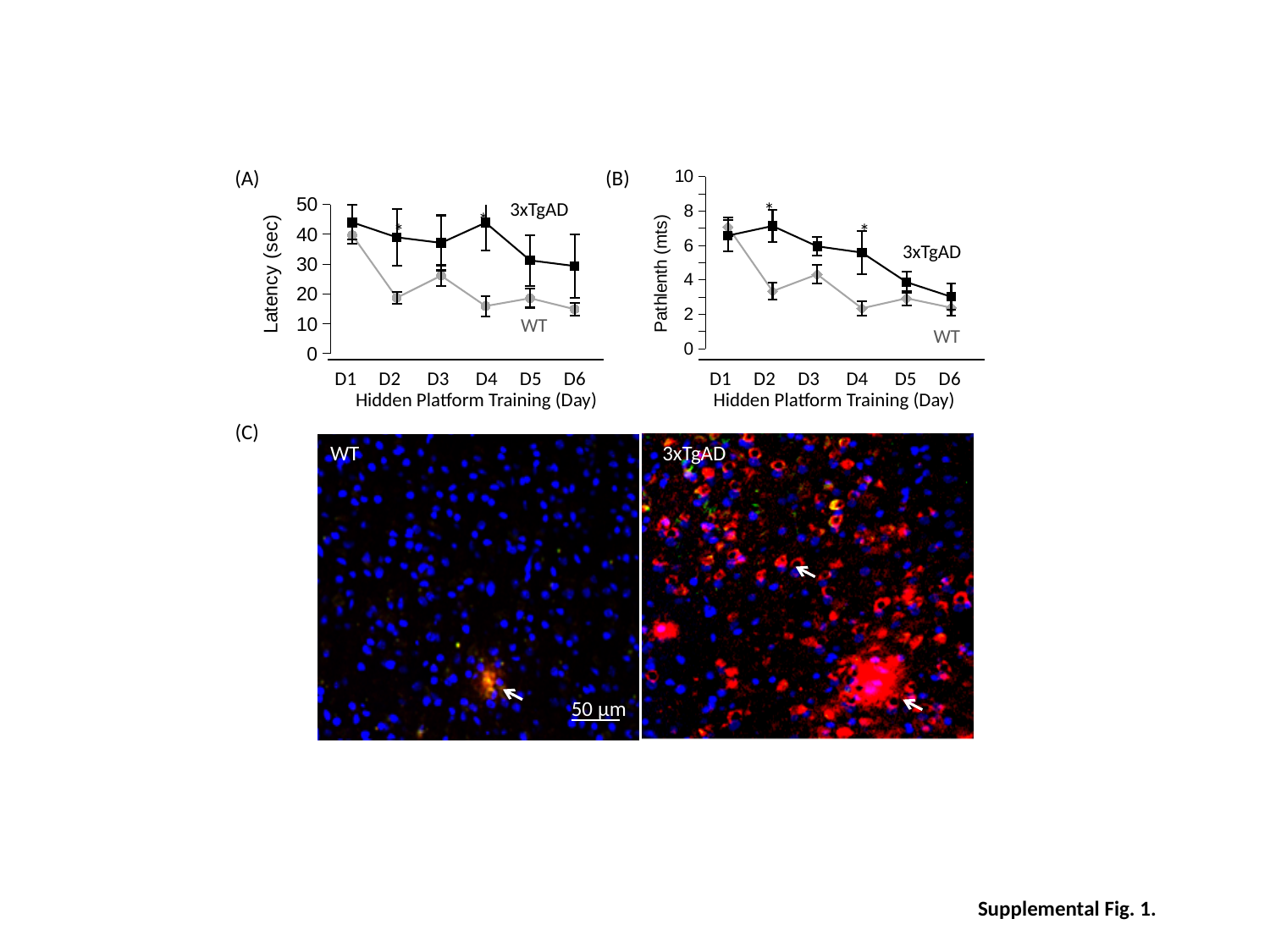
In chart (A), is the 3xTgAD latency at D1 greater or less than 40? greater In chart (A), is the WT latency at D2 greater or less than 30? less What is the x-axis title of chart (A)? Hidden Platform Training (Day) In chart (B), is the WT path length at D4 greater or less than 4? less In chart (B), does the 3xTgAD path length rise or fall from D2 to D6? fall In chart (B), at D2, which group has the higher path length, 3xTgAD or WT? 3xTgAD What is the y-axis label of chart (B)? Pathlenth (mts) How many training days are shown on the x axis of chart (A)? 6 What type of chart is chart (A)? line chart In chart (A), at D4, which group has the higher latency, 3xTgAD or WT? 3xTgAD How many series are plotted in chart (B)? 2